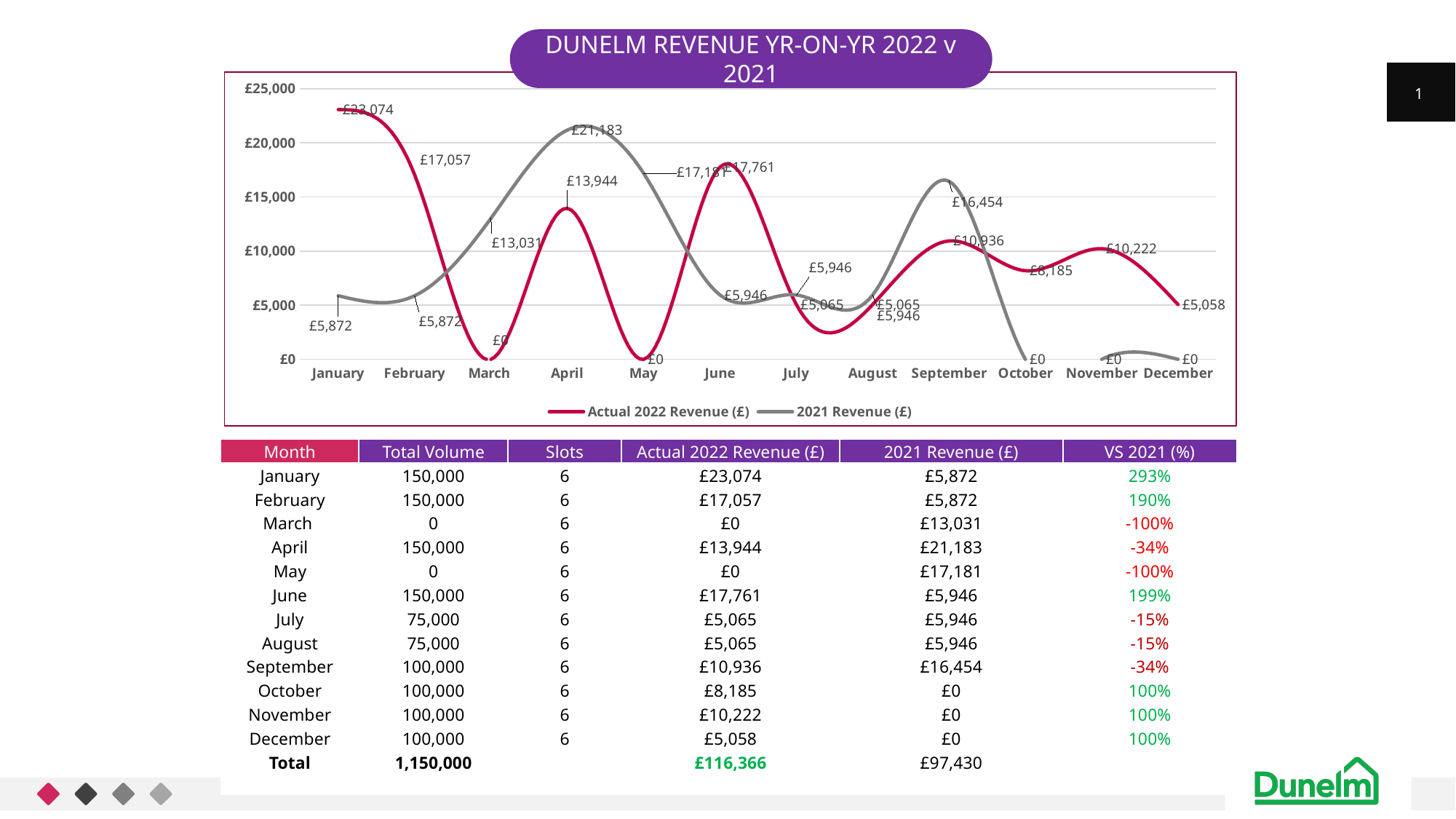
What is the Actual 2022 Revenue (£) for January? £23,074 What is the 2021 Revenue (£) for April? £21,183 How many series does the chart legend list? 2 Which month has the highest 2021 Revenue (£)? April Is the Actual 2022 Revenue (£) for October greater or less than £10,000? less What is the difference between the 2021 Revenue (£) and the Actual 2022 Revenue (£) in September? £5,518 How many months are plotted along the x axis of the chart? 12 What is the Actual 2022 Revenue (£) for December? £5,058 What is the title of the chart? DUNELM REVENUE YR-ON-YR 2022 v 2021 Which month has the highest Actual 2022 Revenue (£)? January In June, which series is larger: Actual 2022 Revenue (£) or 2021 Revenue (£)? Actual 2022 Revenue (£) What kind of chart is shown on the slide? line chart